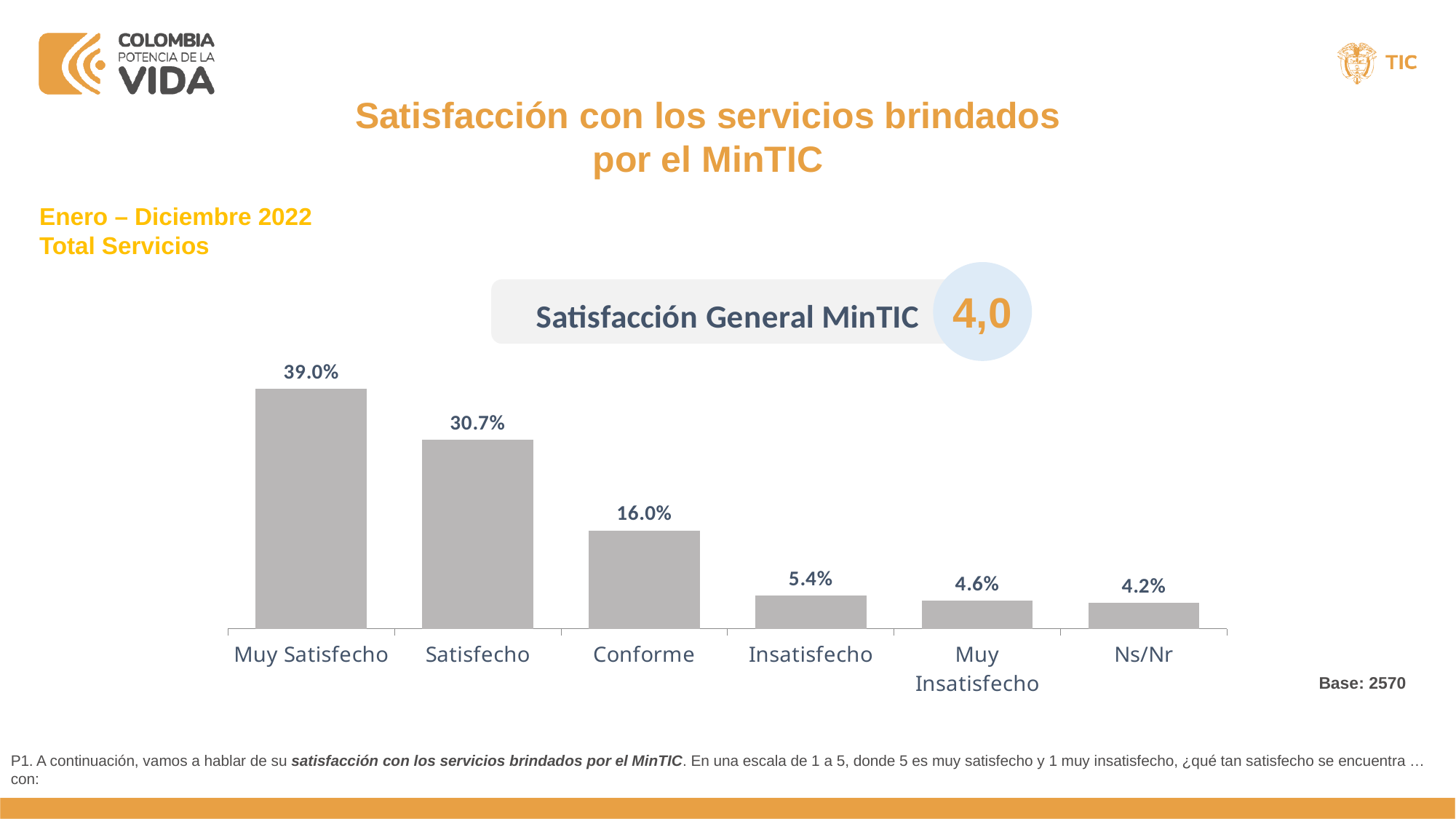
Which is larger, 'Satisfecho' or 'Conforme'? Satisfecho What is the value shown for 'Conforme'? 16.0% What is the difference between 'Muy Satisfecho' and 'Satisfecho'? 8.3% What kind of chart is shown on the slide? Bar chart What percentage of respondents are 'Muy Satisfecho'? 39.0% What is the 'Satisfacción General MinTIC' score shown on the slide? 4,0 How many categories are shown on the x axis? 6 Do the values rise or fall from left to right along the x axis? Fall Which category has the highest value? Muy Satisfecho What is the difference between 'Insatisfecho' and 'Muy Insatisfecho'? 0.8% What percentage is shown for 'Ns/Nr'? 4.2% Which category has the lowest value? Ns/Nr